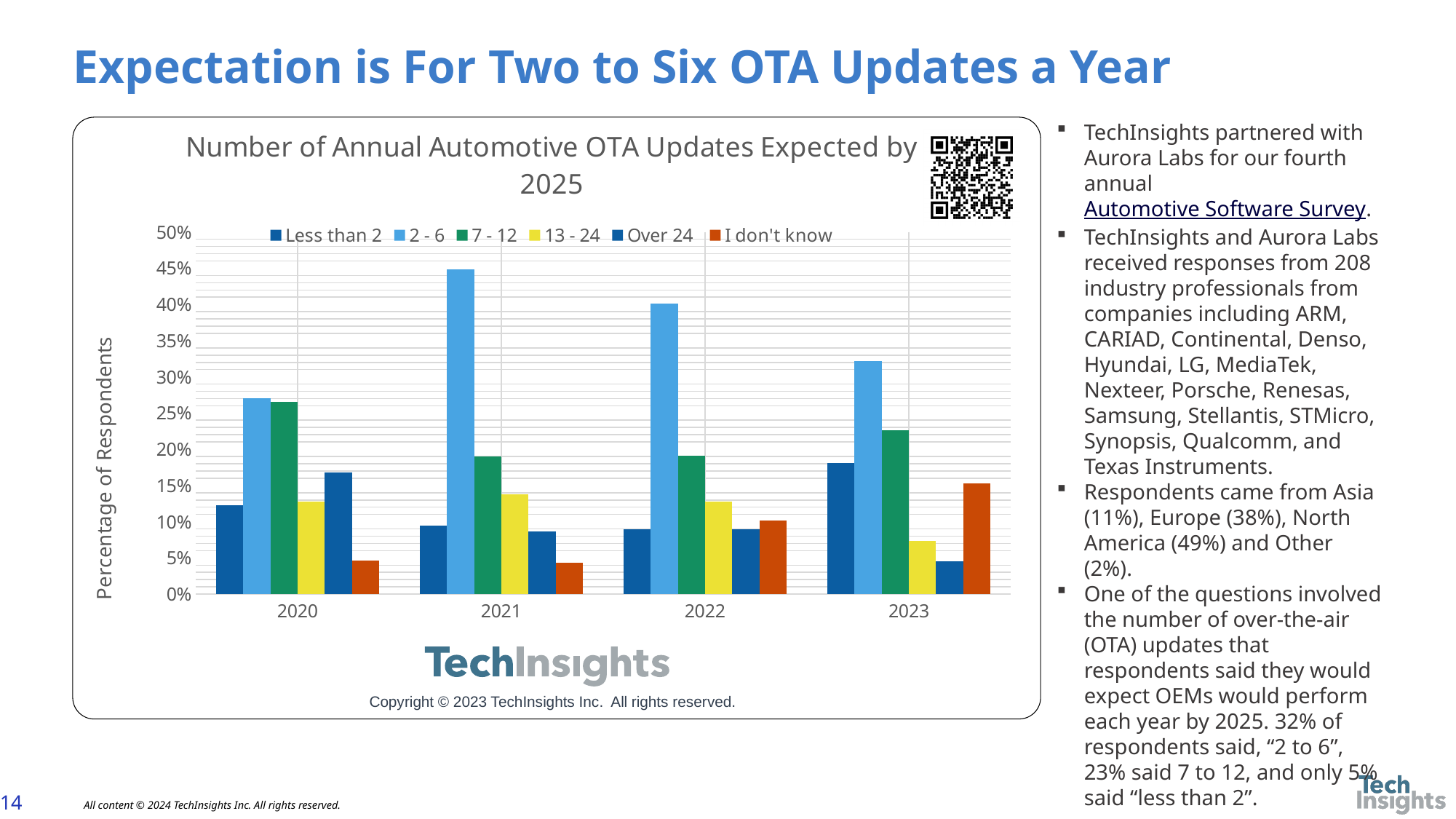
Does the value for '2 - 6' rise or fall from 2021 to 2023? fall What kind of chart is shown on the slide? bar chart Which response category has the lowest value in 2023? Over 24 Is the value for '2 - 6' in 2021 greater or less than 40%? greater Which is larger in 2022: the value for '2 - 6' or the value for '7 - 12'? 2 - 6 How many series does the chart legend list? 6 What is the title of the chart? Number of Annual Automotive OTA Updates Expected by 2025 How many years are shown along the x axis of the chart? 4 What is the label on the y axis of the chart? Percentage of Respondents Is the value for '7 - 12' in 2023 greater or less than 20%? greater Which response category has the highest value in 2021? 2 - 6